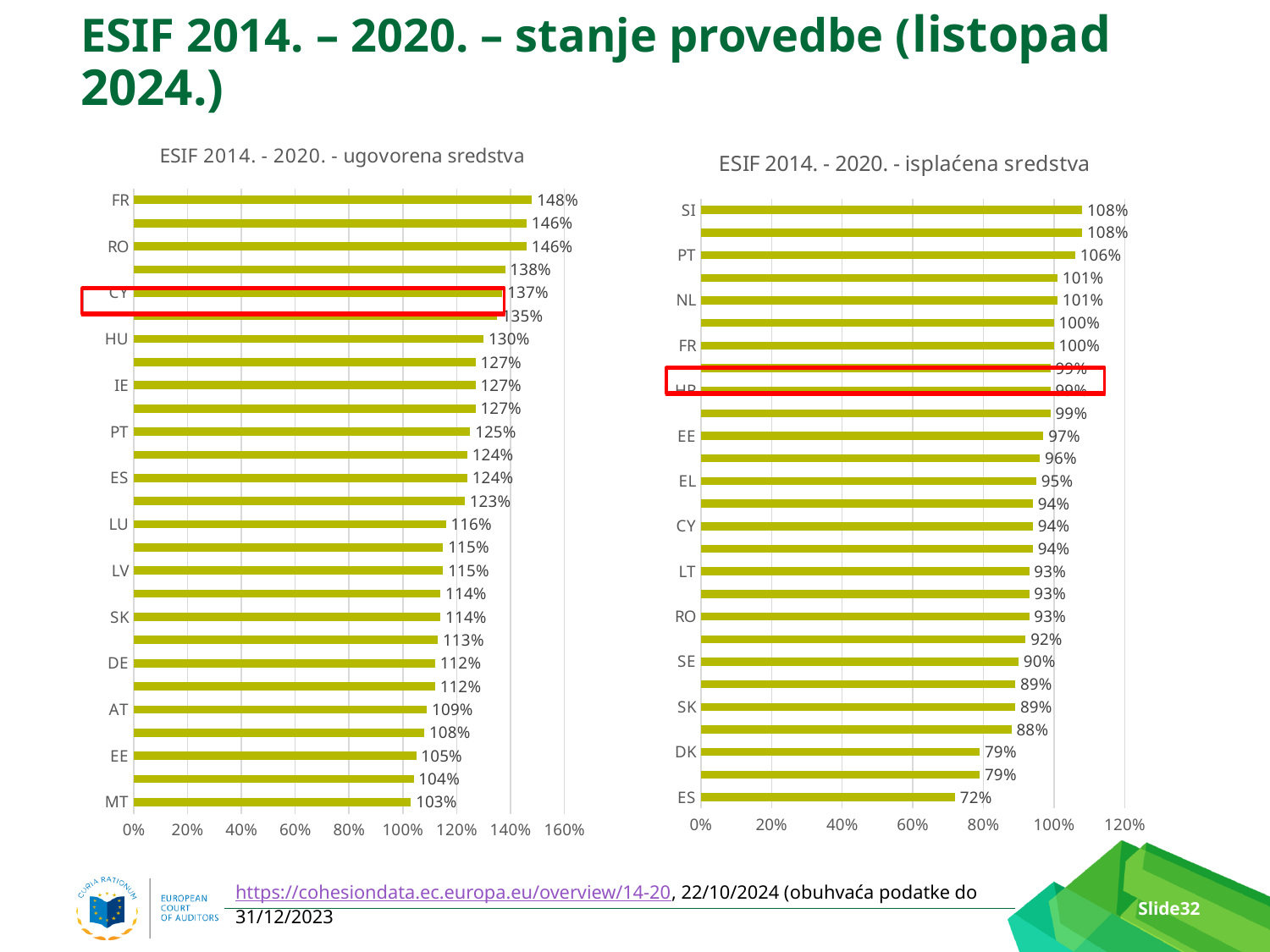
In the right chart (isplaćena sredstva), what is the value for SI? 108% Is the value for PT larger in the left chart (ugovorena sredstva) or in the right chart (isplaćena sredstva)? Left chart (ugovorena sredstva) In the right chart (isplaćena sredstva), what is the value for ES? 72% In the right chart (isplaćena sredstva), what is the difference between the values for SI and ES? 36 percentage points In the right chart (isplaćena sredstva), which country has the lowest value? ES In the left chart (ugovorena sredstva), what is the value for MT? 103% In the left chart (ugovorena sredstva), is the value for HU greater or less than 120%? greater In the left chart (ugovorena sredstva), what is the value for FR? 148% What kind of chart is the right chart (isplaćena sredstva)? Bar chart In the left chart (ugovorena sredstva), what is the difference between the values for FR and MT? 45 percentage points What is the title of the left chart? ESIF 2014. - 2020. - ugovorena sredstva In the left chart (ugovorena sredstva), which country has the highest value? FR